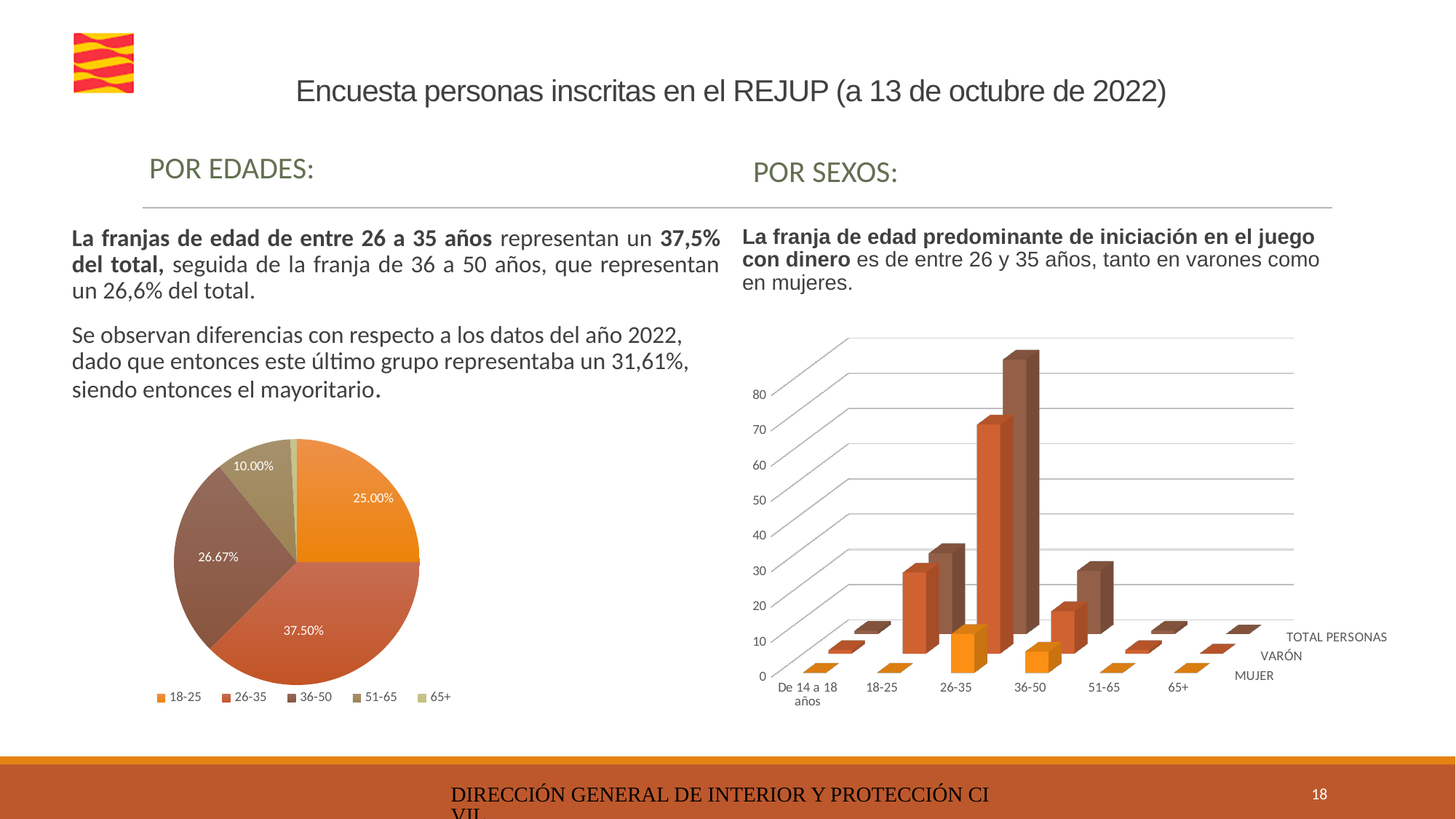
In the bar chart on the right (POR SEXOS), which age category has the highest TOTAL PERSONAS bar? 26-35 In the pie chart on the left (POR EDADES), which age group has the largest slice? 26-35 What kind of chart is shown on the right under POR SEXOS? Bar chart In the pie chart on the left (POR EDADES), what share does the 51-65 slice represent? 10.00% In the bar chart on the right (POR SEXOS), is the VARÓN value for 26-35 greater or less than 50? greater In the bar chart on the right (POR SEXOS), how many series does the legend list? 3 In the pie chart on the left (POR EDADES), which age group has the smallest slice? 65+ In the pie chart on the left (POR EDADES), what is the difference in percentage points between the 26-35 slice and the 18-25 slice? 12.50% In the pie chart on the left (POR EDADES), what share does the 26-35 slice represent? 37.50% In the bar chart on the right (POR SEXOS), how many age categories are shown on the x axis? 6 In the pie chart on the left (POR EDADES), how many age groups does the legend list? 5 In the pie chart on the left (POR EDADES), what share does the 36-50 slice represent? 26.67%